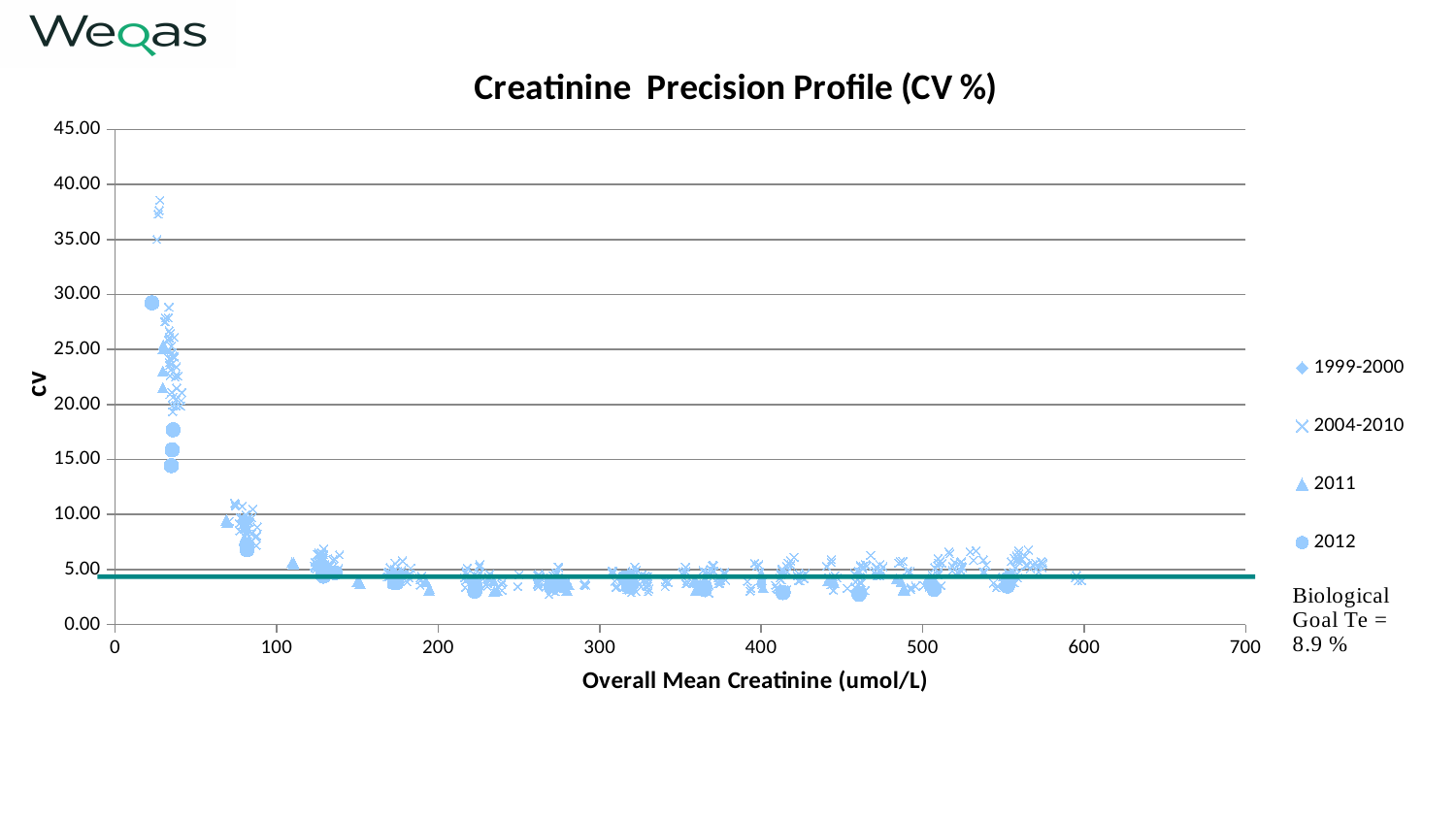
Are the CV values plotted at an Overall Mean Creatinine of around 80 greater or less than 15.00? less What kind of chart is shown on the slide? Scatter chart Are the CV values plotted at an Overall Mean Creatinine of around 300 greater or less than 10.00? less Are the highest CV values plotted for samples with Overall Mean Creatinine below 100 greater or less than 35.00? greater How many series does the legend list? 4 What is the maximum value shown on the CV axis? 45.00 What is the label of the x axis? Overall Mean Creatinine (umol/L) Which region of the x axis contains the highest CV values: below 100 or above 500? Below 100 What is the title of the chart? Creatinine Precision Profile (CV %) What is the Biological Goal Te value stated next to the chart? 8.9 % Do the CV values generally rise or fall as Overall Mean Creatinine increases along the x axis? Fall